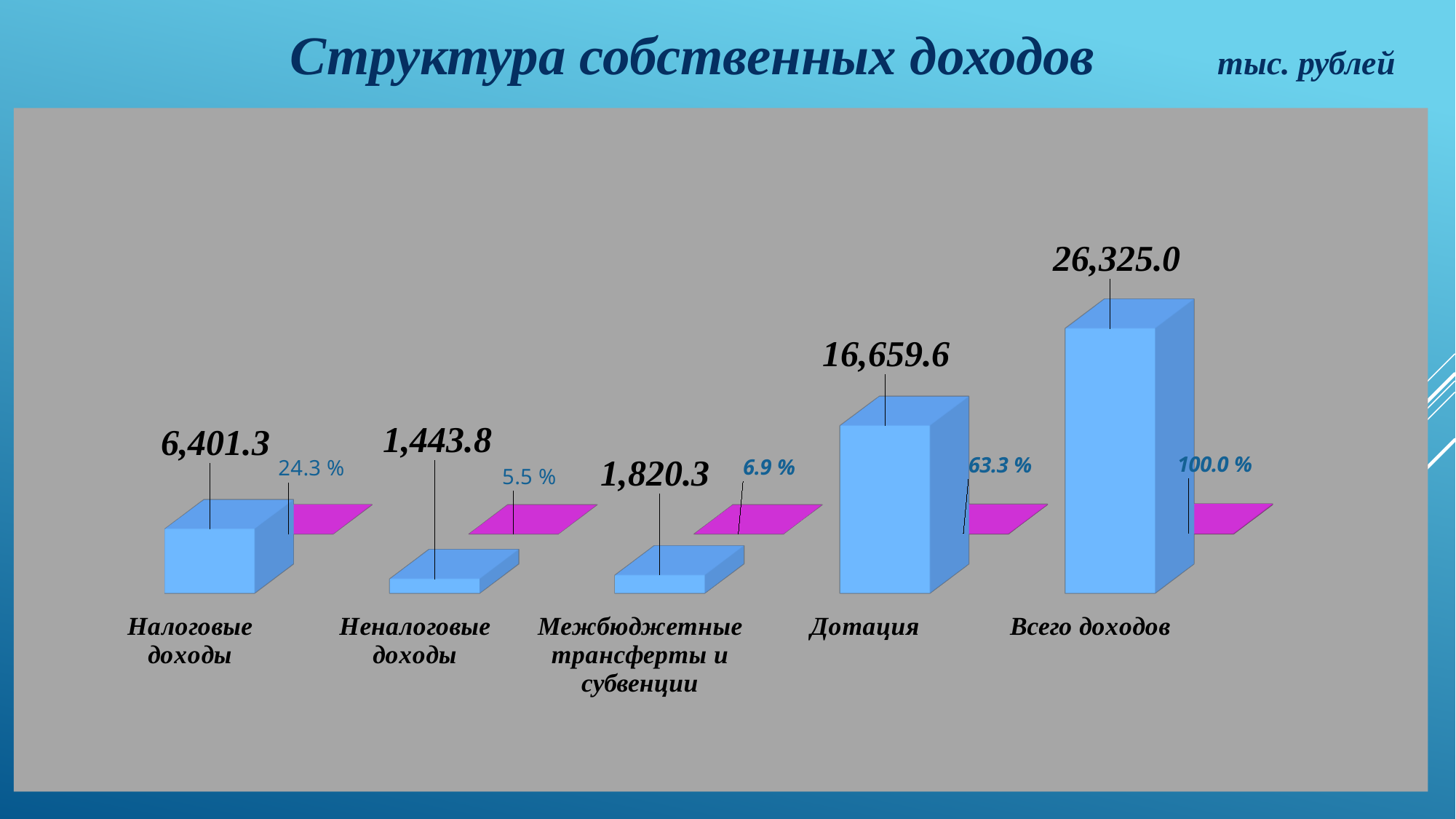
Which category has the lowest value? Неналоговые доходы What is the value for Межбюджетные трансферты и субвенции? 1,820.3 How many categories are shown on the chart? 5 What is the value for Дотация? 16,659.6 What percentage is shown for Дотация? 63.3 % What is the difference between Всего доходов and Дотация? 9,665.4 Which category has the highest value? Всего доходов Which is larger, Межбюджетные трансферты и субвенции or Неналоговые доходы? Межбюджетные трансферты и субвенции What is the difference between Налоговые доходы and Неналоговые доходы? 4,957.5 What percentage is shown for Неналоговые доходы? 5.5 % What is the value for Налоговые доходы? 6,401.3 What is the title of the chart? Структура собственных доходов